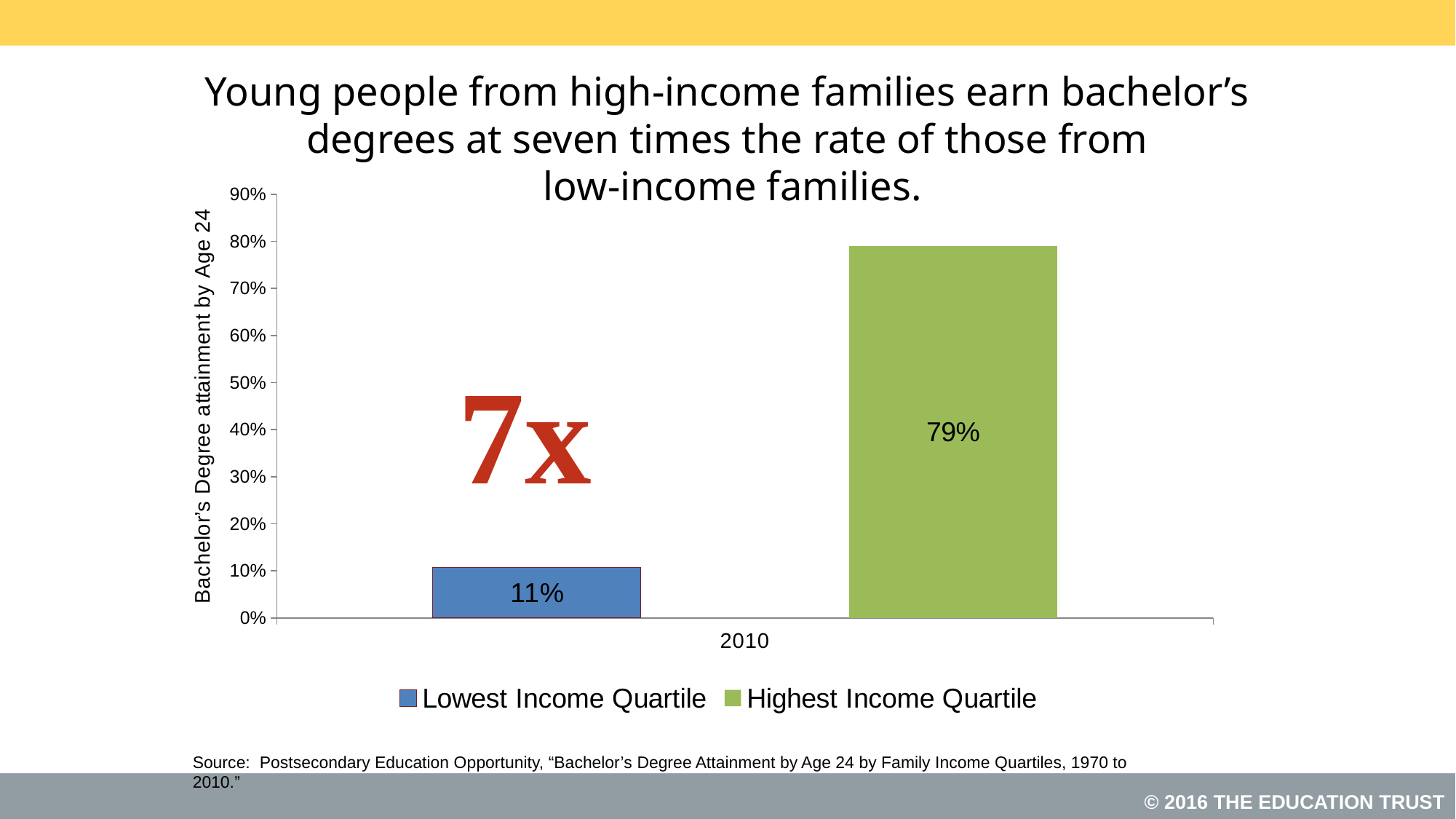
Which income quartile has the higher bachelor's degree attainment rate? Highest Income Quartile What is the difference in percentage points between the Highest Income Quartile and the Lowest Income Quartile? 68 percentage points Which income quartile has the lower bachelor's degree attainment rate? Lowest Income Quartile How many series does the legend list? 2 What is the bachelor's degree attainment rate for the Highest Income Quartile? 79% What year is shown on the x axis of the chart? 2010 What kind of chart is shown on the slide? Bar chart What is the bachelor's degree attainment rate for the Lowest Income Quartile? 11% What is the label on the vertical axis of the chart? Bachelor's Degree attainment by Age 24 What is the highest value shown on the vertical axis? 90% Is the value for the Lowest Income Quartile greater or less than 20%? less Is the value for the Highest Income Quartile greater or less than 70%? greater